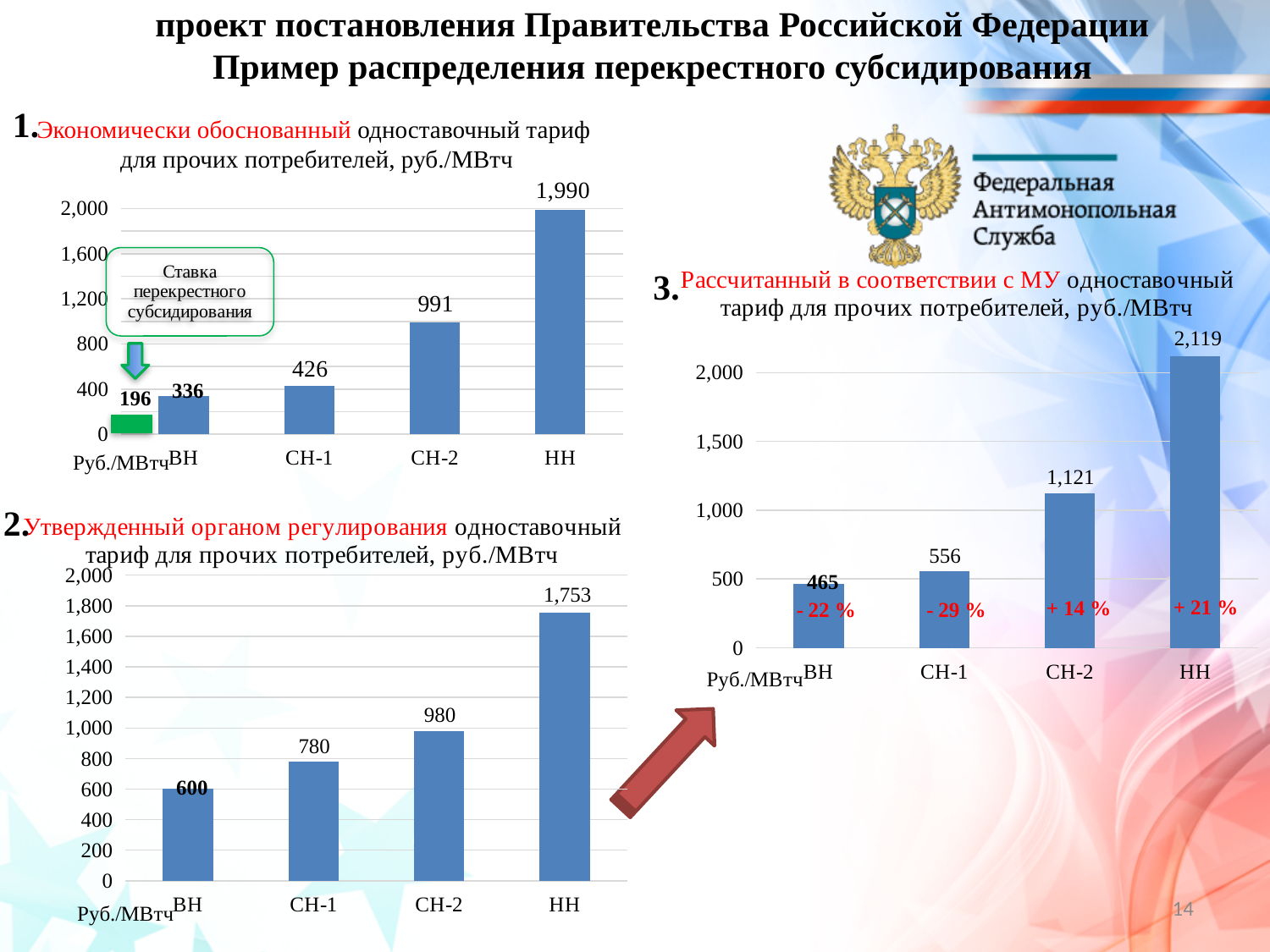
In chart 3 (right), what is the difference between the values for НН and ВН? 1,654 In chart 3 (right), what percentage change is printed on the bar for СН-1? - 29 % In chart 2 (bottom left), which category has the lowest value? ВН In chart 2 (bottom left), what is the difference between the values for СН-2 and СН-1? 200 In chart 3 (right, tariff calculated according to МУ), what is the value for СН-2? 1,121 In chart 1 (top left), what is the value for СН-2? 991 In chart 1 (top left), which is larger: the value for СН-1 or the value for ВН? СН-1 How many categories are shown on the x axis of chart 3 (right)? 4 What type of chart is chart 2 (bottom left)? Bar chart In chart 3 (right), which category has the highest value? НН In chart 2 (bottom left, tariff approved by the regulator), what is the value for СН-1? 780 In chart 1 (top left, economically justified tariff), what is the value for НН? 1,990